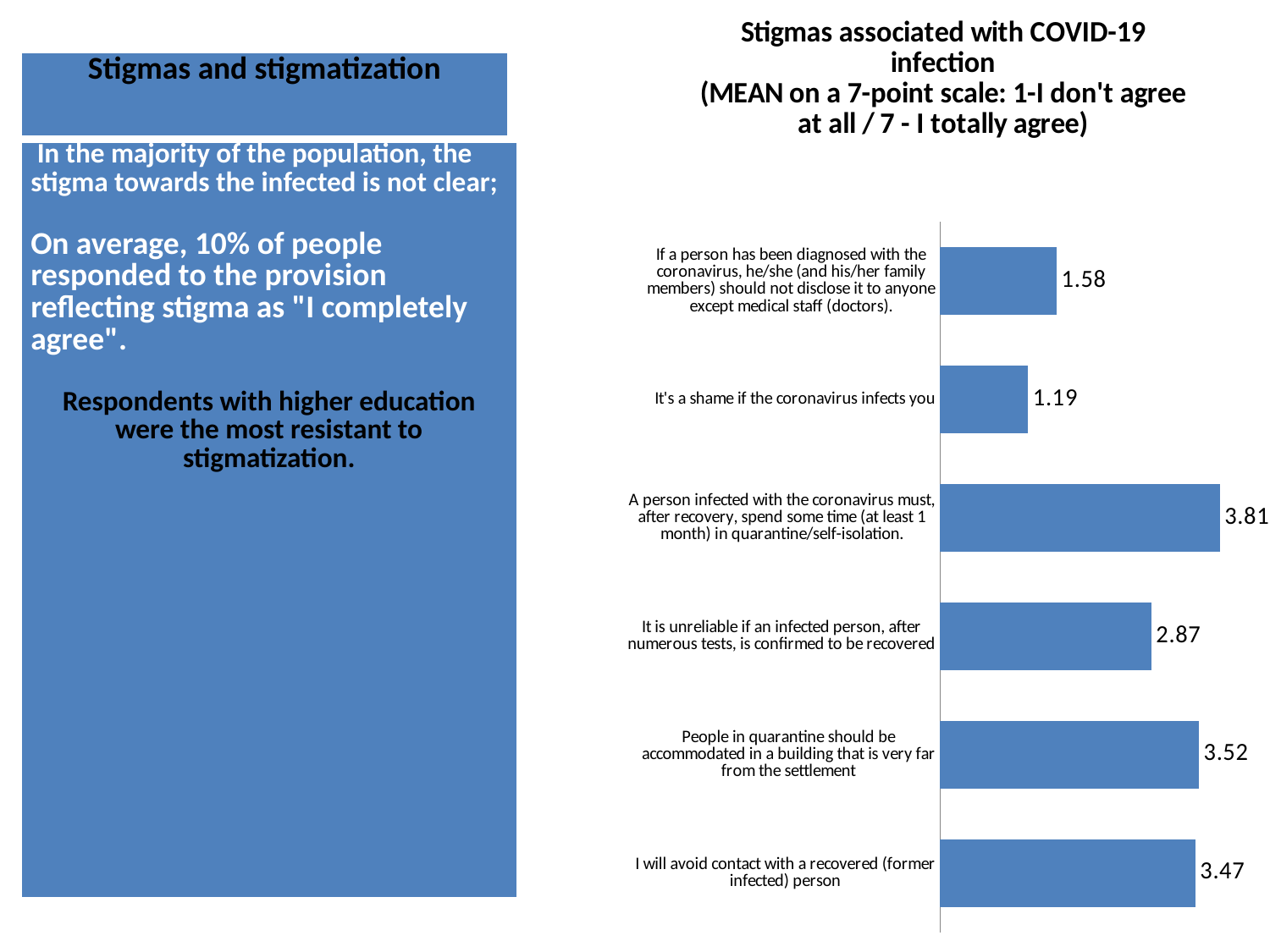
Which has a larger mean value: "It is unreliable if an infected person, after numerous tests, is confirmed to be recovered" or "I will avoid contact with a recovered (former infected) person"? I will avoid contact with a recovered (former infected) person What is the title of the chart? Stigmas associated with COVID-19 infection (MEAN on a 7-point scale: 1-I don't agree at all / 7 - I totally agree) What is the mean value for "It's a shame if the coronavirus infects you"? 1.19 Which statement has the highest mean value? A person infected with the coronavirus must, after recovery, spend some time (at least 1 month) in quarantine/self-isolation. What is the difference between the mean values for "People in quarantine should be accommodated in a building that is very far from the settlement" and "I will avoid contact with a recovered (former infected) person"? 0.05 What is the difference between the mean values for the quarantine/self-isolation statement (3.81) and the statement about not disclosing a diagnosis (1.58)? 2.23 What kind of chart is shown on the slide? Bar chart What is the mean value for "I will avoid contact with a recovered (former infected) person"? 3.47 How many statements are plotted in the chart? 6 Which statement has the lowest mean value? It's a shame if the coronavirus infects you What is the mean value for "It is unreliable if an infected person, after numerous tests, is confirmed to be recovered"? 2.87 What is the mean value for "People in quarantine should be accommodated in a building that is very far from the settlement"? 3.52